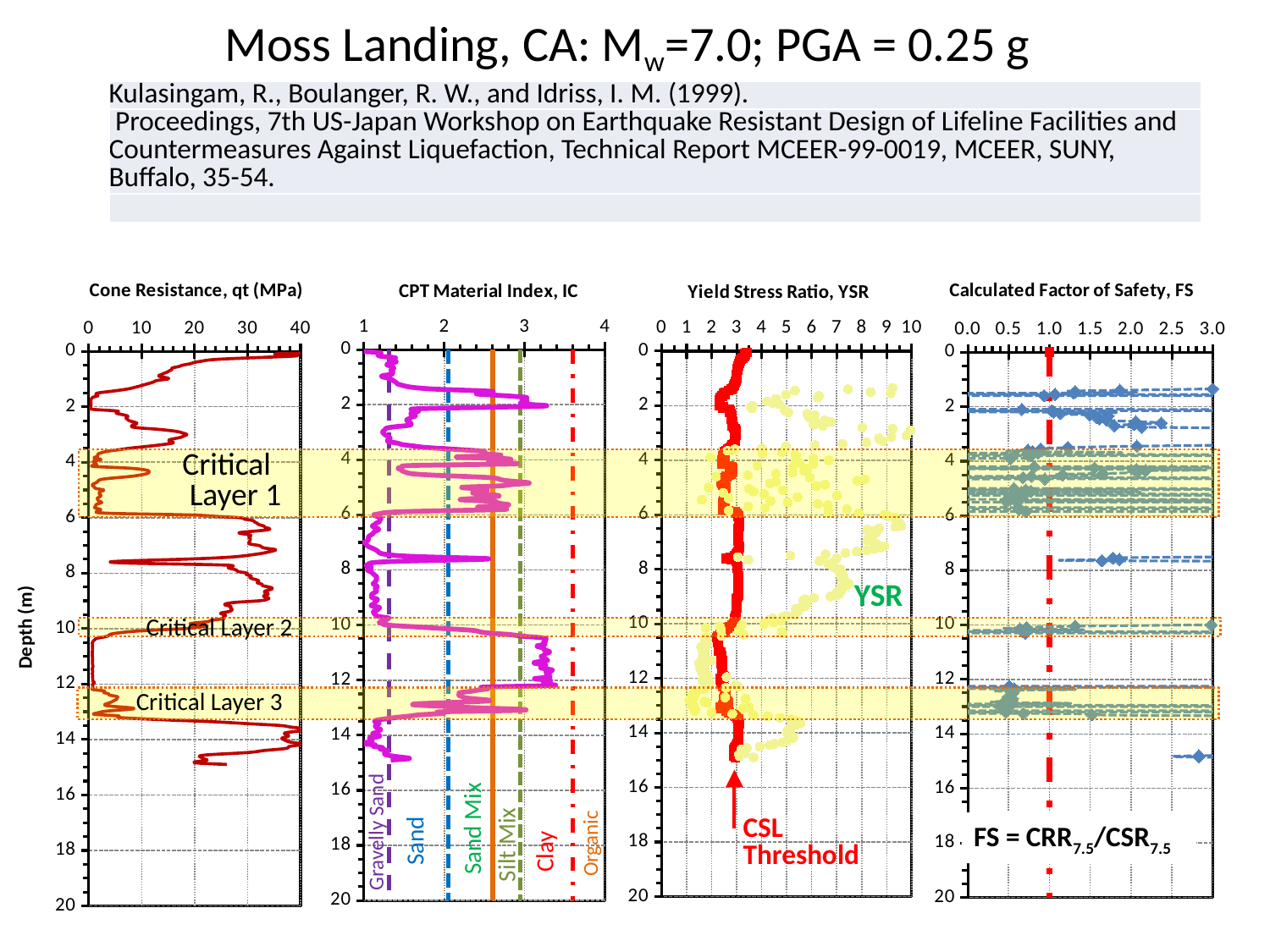
In the CPT Material Index, IC chart, is the value at a depth of 15 m greater or less than 2? less In the Calculated Factor of Safety, FS chart, is the data point at a depth of about 14.8 m greater or less than 2.5? greater Which critical layer covers the largest depth range, Critical Layer 1 or Critical Layer 2? Critical Layer 1 In the Yield Stress Ratio, YSR chart, is the red CSL Threshold line at a depth of 8 m greater or less than 2? greater In the Calculated Factor of Safety, FS chart, at what value is the vertical red dash-dot reference line drawn? 1.0 How many charts are shown on the slide? 4 What kind of chart is the Cone Resistance, qt (MPa) chart? line chart How many critical layers are marked across the charts? 3